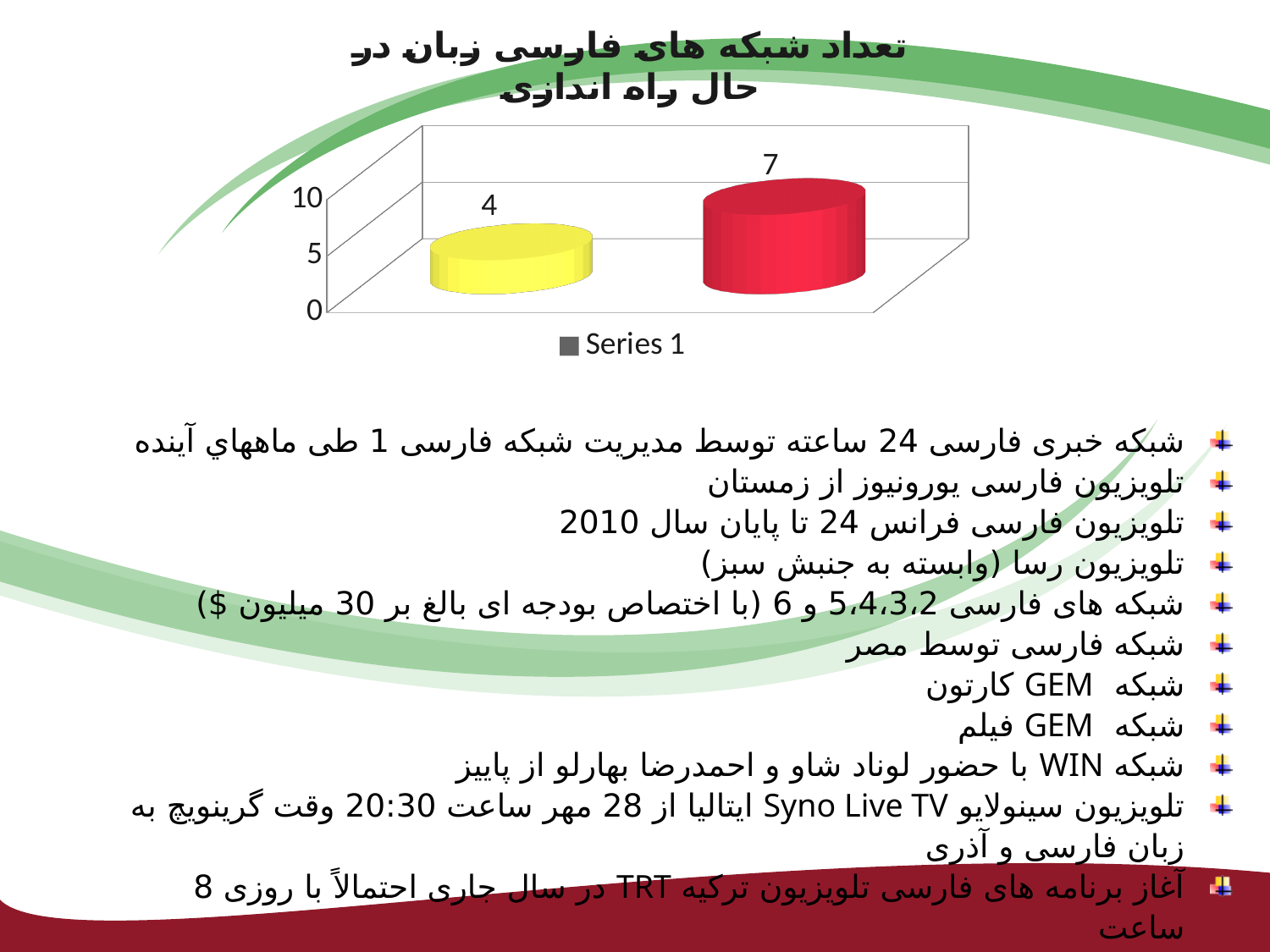
Is the value of the left bar larger or smaller than the value of the right bar? smaller What kind of chart is shown on the slide? bar chart What is the value of the yellow bar in the chart? 4 Which bar has the highest value, the yellow one or the red one? the red bar Which bar has the lowest value, the yellow one or the red one? the yellow bar What is the name of the series shown in the chart legend? Series 1 How many series does the chart legend list? 1 Is the value of the yellow bar greater or less than 5? less Is the value of the red bar greater or less than 5? greater How many bars are plotted in the chart? 2 What is the difference between the red bar's value and the yellow bar's value? 3 What is the value of the red bar in the chart? 7